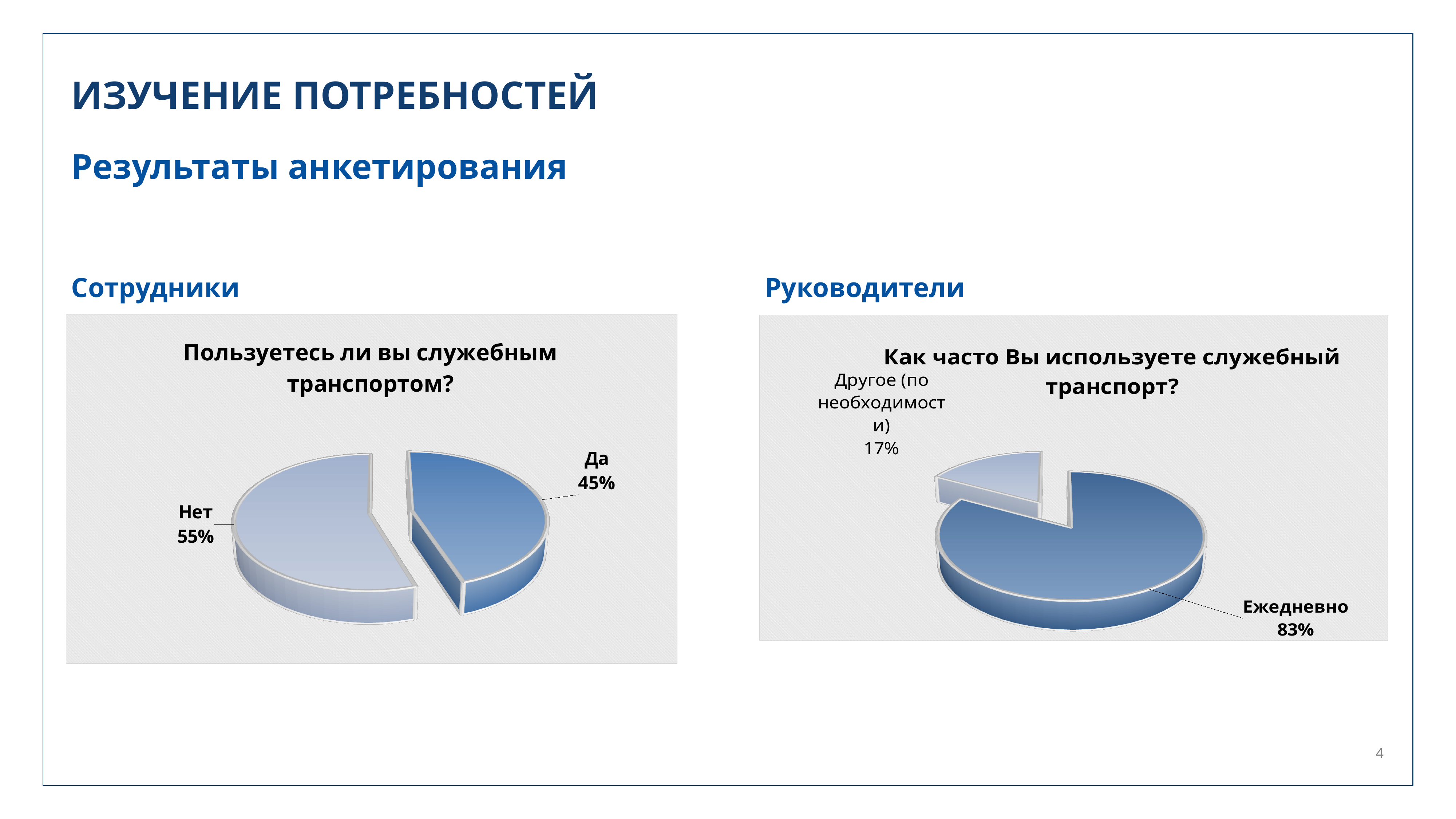
In the left chart (Сотрудники), what is the difference in percentage points between "Нет" and "Да"? 10% In the left chart (Сотрудники), which answer has the larger share? Нет In the left chart (Сотрудники), what share of respondents answered "Нет"? 55% In the right chart (Руководители), what is the difference in percentage points between "Ежедневно" and "Другое (по необходимости)"? 66% In the right chart (Руководители), what share of respondents answered "Ежедневно"? 83% In the left chart (Сотрудники), what share of respondents answered "Да"? 45% What is the title of the left chart (Сотрудники)? Пользуетесь ли вы служебным транспортом? In the left chart (Сотрудники), how many slices does the pie have? 2 In the right chart (Руководители), which answer has the smallest share? Другое (по необходимости) What is the title of the right chart (Руководители)? Как часто Вы используете служебный транспорт? What type of chart is shown on the left (Сотрудники)? Pie chart In the right chart (Руководители), what share of respondents answered "Другое (по необходимости)"? 17%